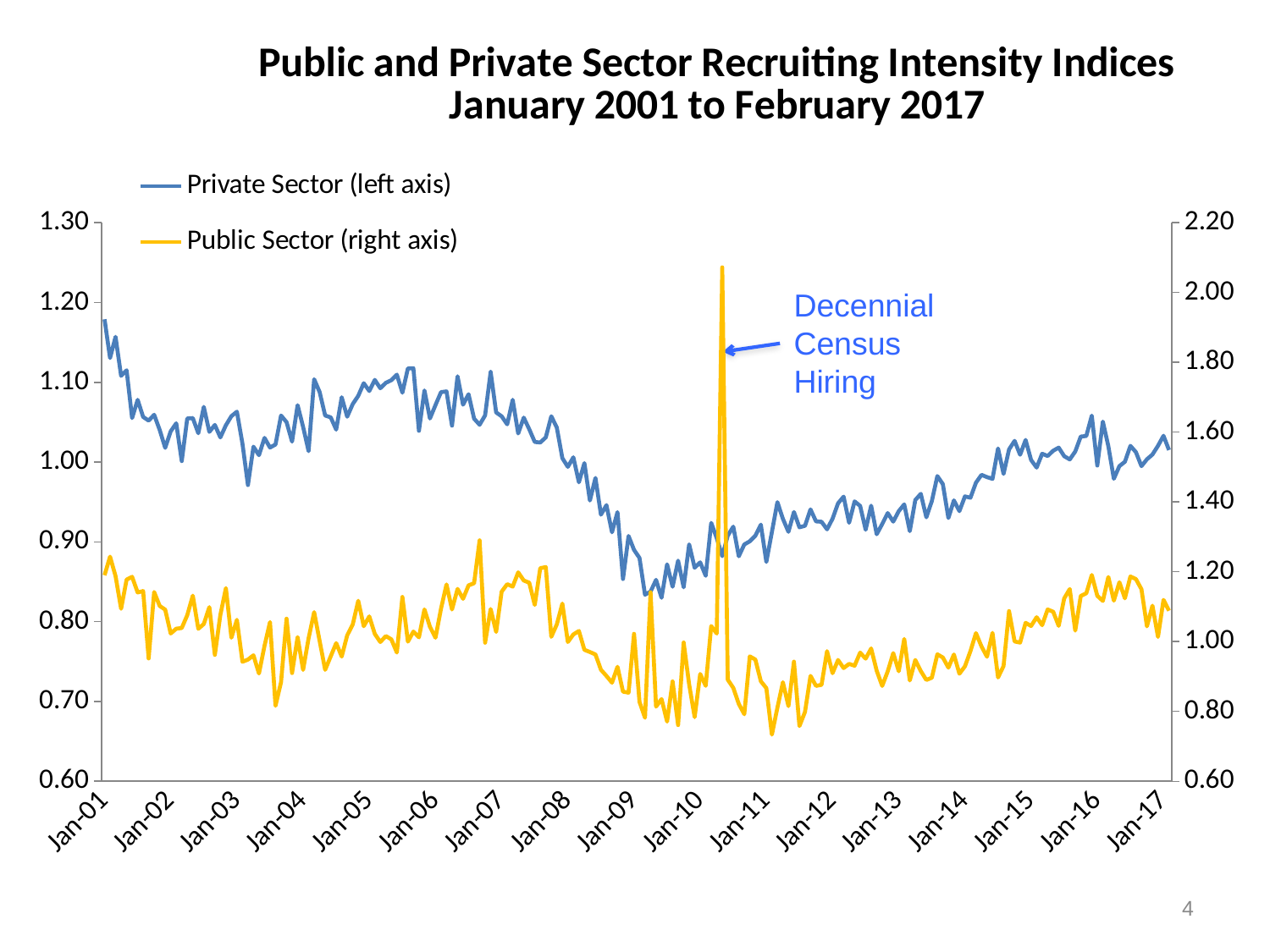
Does the Private Sector series rise or fall between Jan-07 and Jan-09? fall Which series is plotted on the right axis according to the legend? Public Sector What kind of chart is shown on the slide? line chart Does the Public Sector series generally rise or fall between Jan-12 and Jan-16? rise Does the Private Sector series generally rise or fall between Jan-10 and Jan-17? rise Is the peak of the Public Sector spike around 2010 greater or less than 1.80 on the right axis? greater Is the Private Sector value at Jan-01 greater or less than 1.10? greater How many series does the legend list? 2 Is the lowest Public Sector value (around 2011) greater or less than 0.80 on the right axis? less What does the annotation with the arrow label the spike in the Public Sector series around 2010? Decennial Census Hiring How many year labels are shown on the x axis? 17